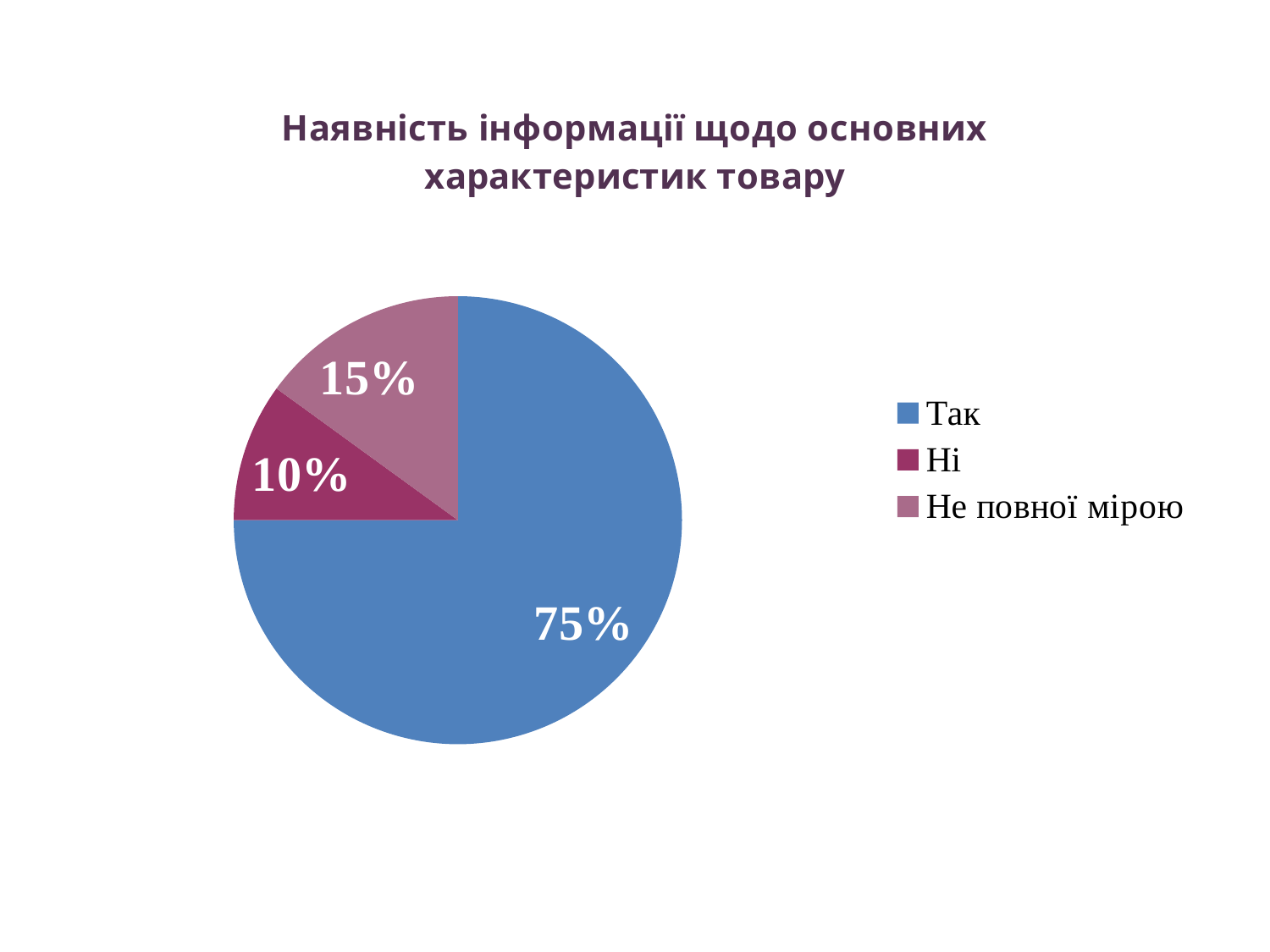
What share of the pie does "Так" represent? 75% What is the difference between the shares for "Не повної мірою" and "Ні"? 5% What share of the pie does "Не повної мірою" represent? 15% What share of the pie does "Ні" represent? 10% What is the title of the chart? Наявність інформації щодо основних характеристик товару Which colour represents "Так" in the legend? Blue What kind of chart is shown on the slide? Pie chart Which category has the smallest slice of the pie? Ні Which category has the largest slice of the pie? Так What is the difference between the shares for "Так" and "Не повної мірою"? 60% Which is larger, the share for "Ні" or the share for "Не повної мірою"? Не повної мірою How many categories are shown in the pie chart? 3